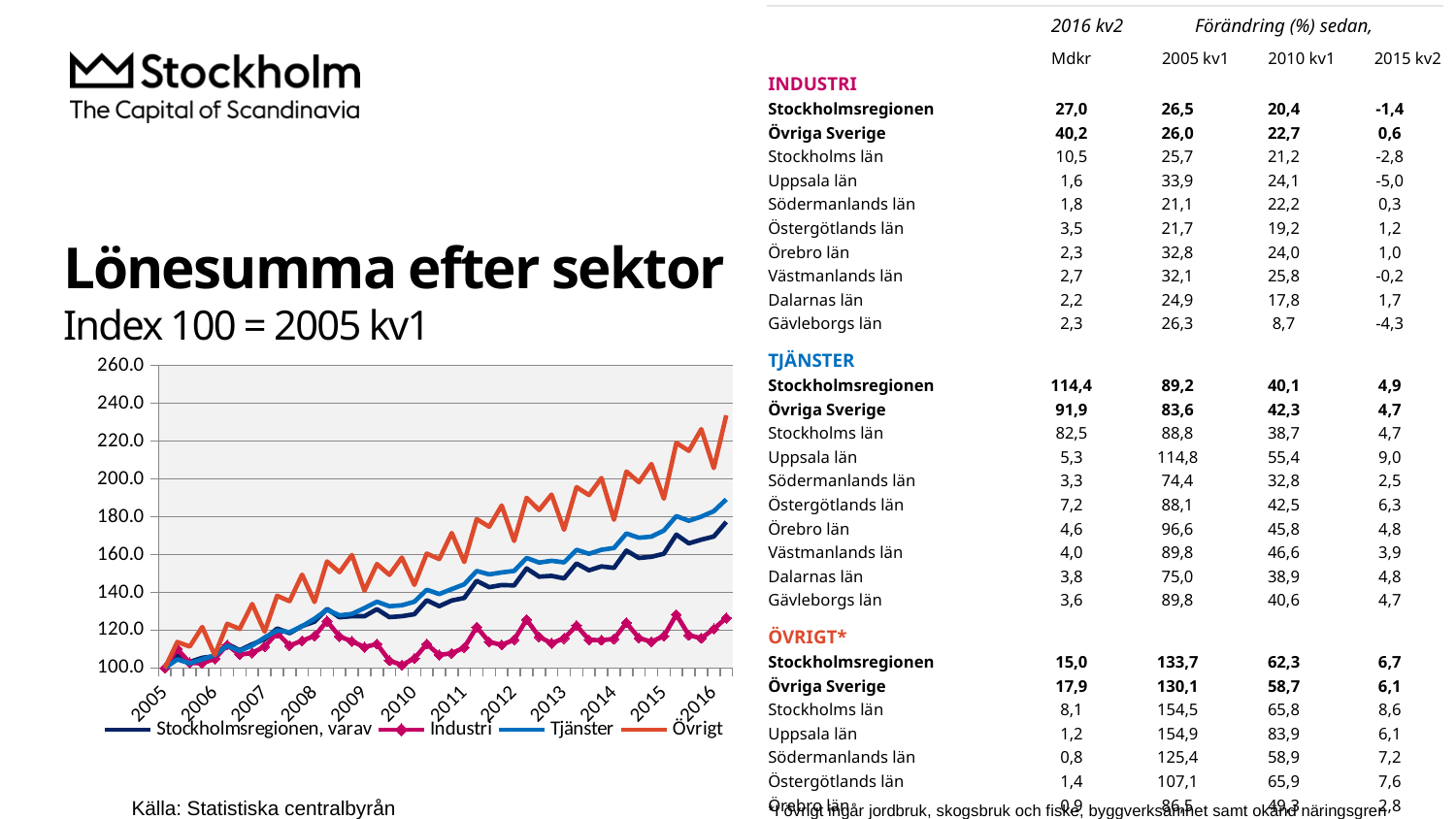
Which series has the lowest value at the end of the period (2016)? Industri Is the value for Övrigt at the end of 2016 greater or less than 220? greater Does the Tjänster series rise or fall from 2005 to 2016? rise How many series does the chart legend list? 4 At the end of 2016, which is higher: Tjänster or Industri? Tjänster Which series reaches the highest value at the end of the period (2016)? Övrigt What kind of chart is shown on the slide? Line chart How many years are labelled on the x axis of the chart? 12 Is the value for Industri at the end of 2016 greater or less than 140? less What is the index base stated under the chart title? Index 100 = 2005 kv1 What is the title of the chart on the slide? Lönesumma efter sektor Is the value for Tjänster at the end of 2016 greater or less than 160? greater